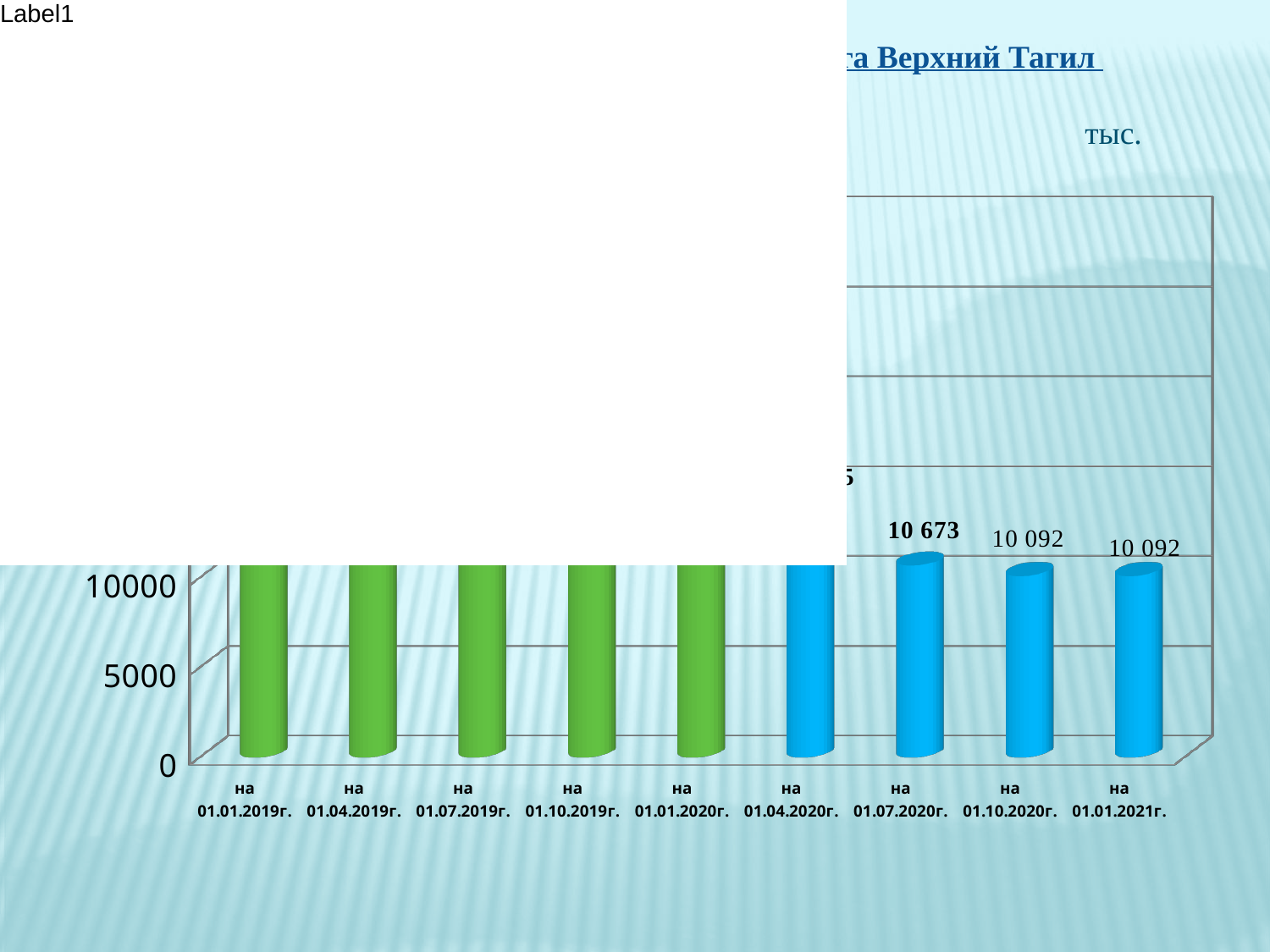
Do the values rise or fall from на 01.07.2020г. to на 01.10.2020г.? fall What is the difference between the values for на 01.07.2020г. and на 01.01.2021г.? 581 Which is larger, the value for на 01.07.2020г. or the value for на 01.10.2020г.? на 01.07.2020г. What colour are the bars for the 2019 dates and на 01.01.2020г.? green Is the value for на 01.07.2020г. greater or less than 10000? greater What is the value for на 01.07.2020г.? 10 673 What is the value for на 01.10.2020г.? 10 092 Is the value for на 01.01.2019г. greater or less than 5000? greater What unit label is shown at the top right of the chart? тыс. What is the value for на 01.01.2021г.? 10 092 What kind of chart is shown on the slide? bar chart How many dates (categories) are shown along the x axis? 9